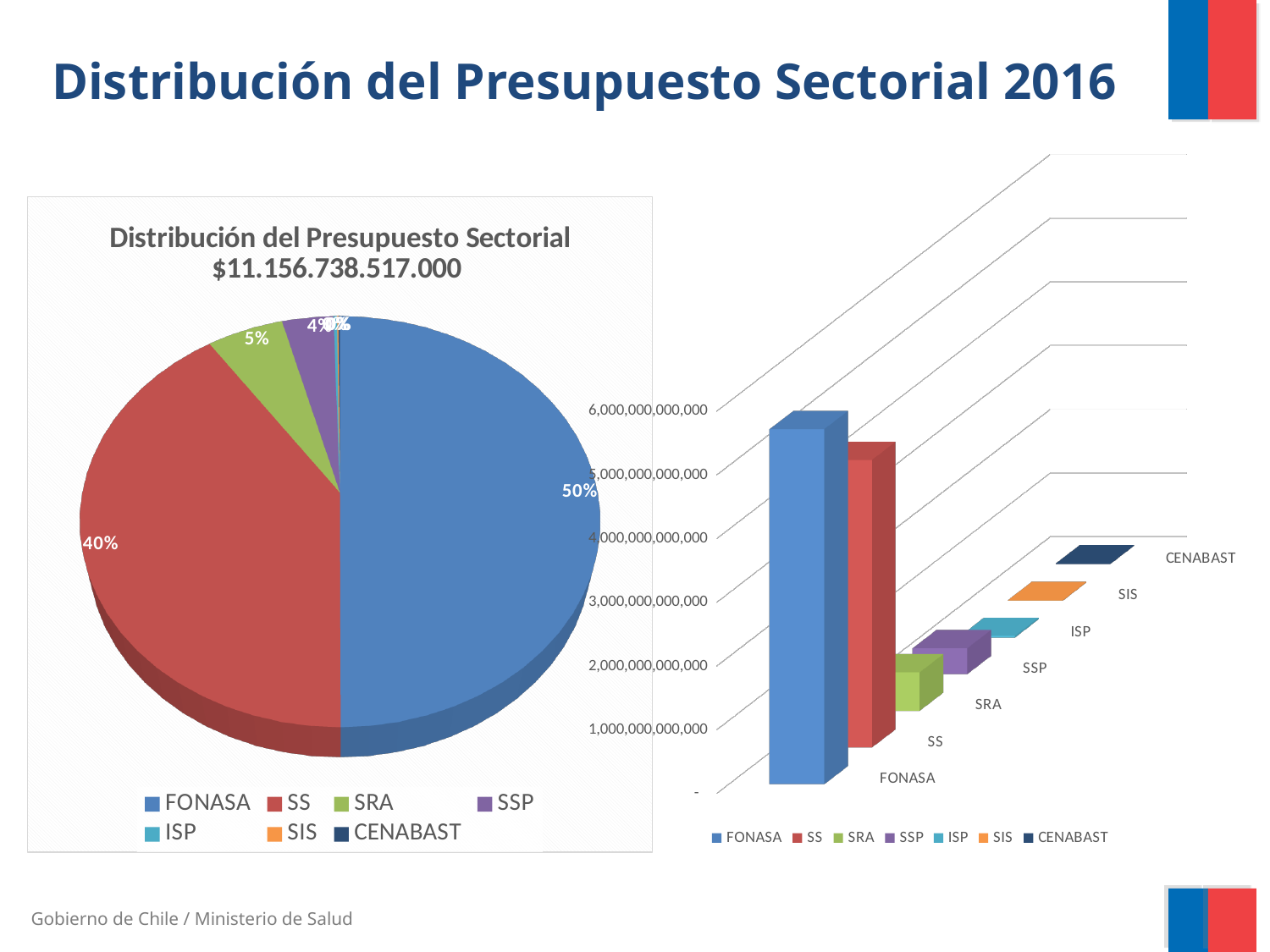
In the pie chart on the left, what share of the budget does FONASA represent? 50% How many categories does the legend of the pie chart on the left list? 7 In the pie chart on the left, what share of the budget does SRA represent? 5% In the bar chart on the right, which category has the tallest bar? FONASA In the pie chart on the left, which category has the largest slice? FONASA What kind of chart is the chart on the right side of the slide? Bar chart In the pie chart on the left, which slice is larger, SRA or SSP? SRA In the pie chart on the left, what share of the budget does SSP represent? 4% What total budget amount is shown in the title of the pie chart on the left? $11.156.738.517.000 In the bar chart on the right, is the value for FONASA greater or less than 4,000,000,000,000? greater In the pie chart on the left, how many percentage points larger is the FONASA share than the SS share? 10 percentage points